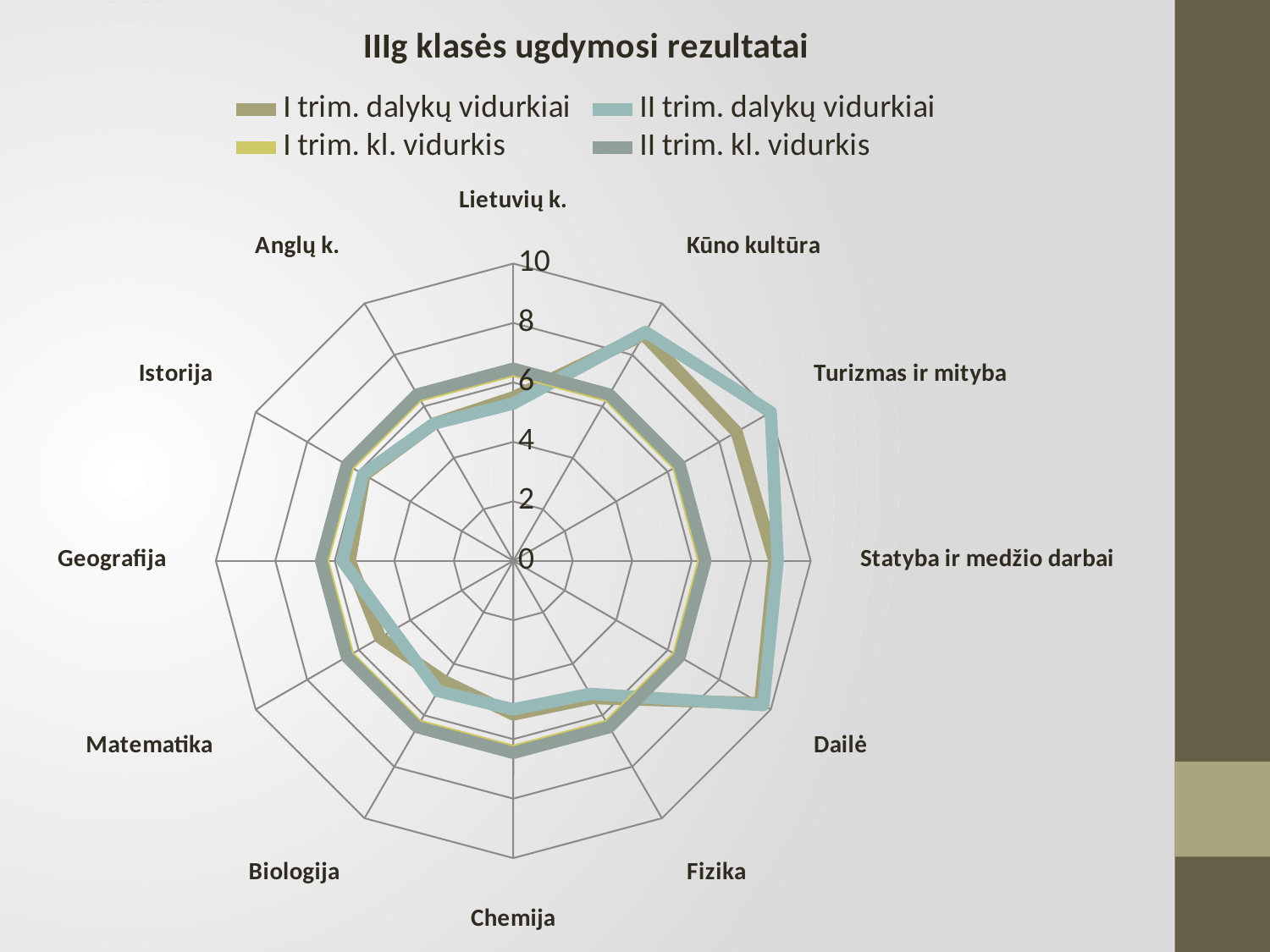
Is the II trim. dalykų vidurkiai value for Turizmas ir mityba greater or less than 8? greater What kind of chart is shown on the slide? radar chart How many series does the legend list? 4 For the II trim. dalykų vidurkiai series, which is larger: the value for Turizmas ir mityba or the value for Matematika? Turizmas ir mityba What is the title of the chart? IIIg klasės ugdymosi rezultatai Is the II trim. dalykų vidurkiai value for Dailė greater or less than 8? greater Which series is drawn in light blue according to the legend? II trim. dalykų vidurkiai Is the II trim. dalykų vidurkiai value for Matematika greater or less than 8? less How many subject categories are plotted around the radar chart? 12 What is the maximum value shown on the radar chart's axis scale? 10